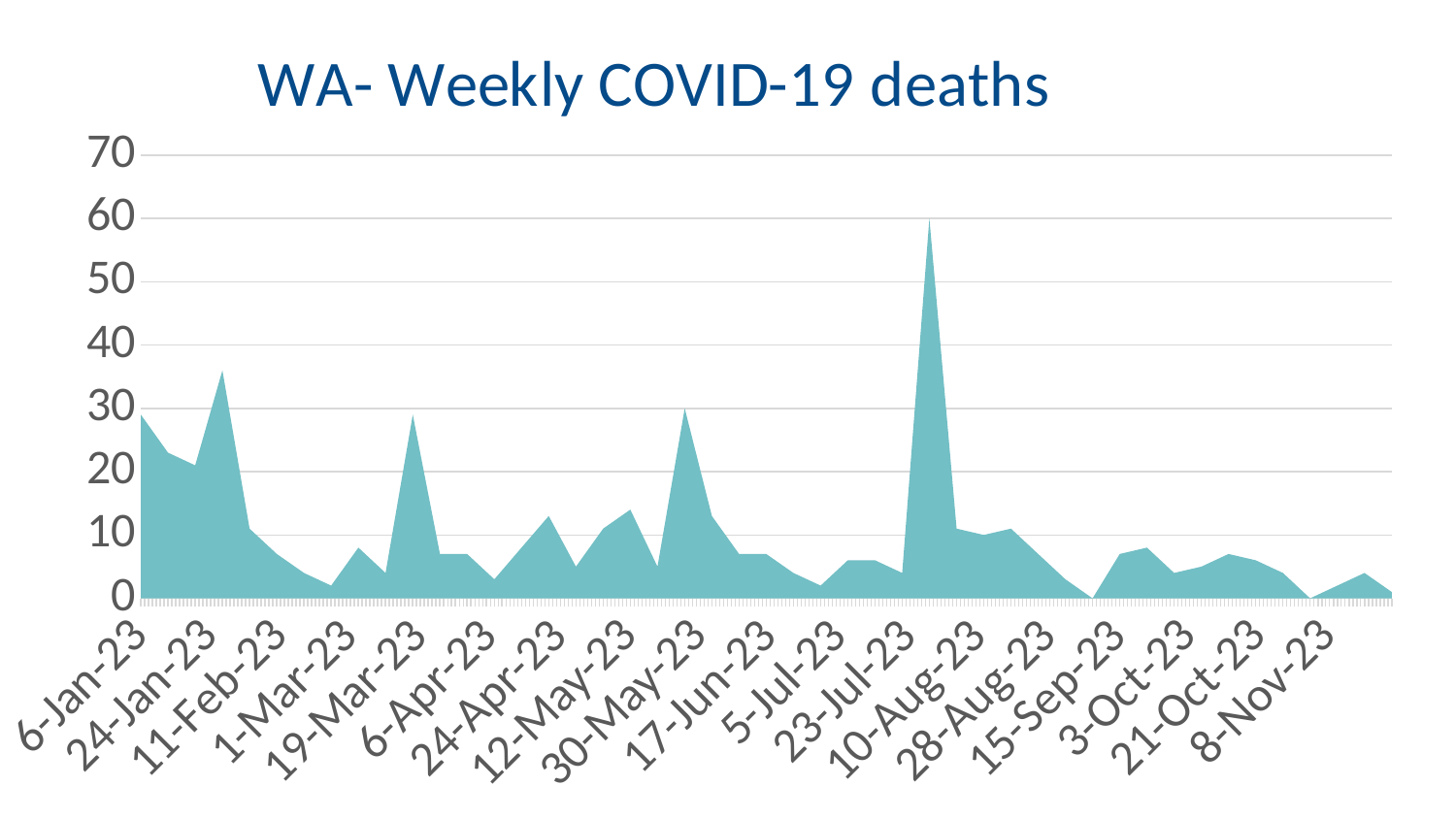
How many date labels are shown on the x axis? 18 Is the value for 5-Jul-23 greater or less than 10? less Is the value for 6-Jan-23 greater or less than 20? greater Which has the larger value, 6-Jan-23 or 8-Nov-23? 6-Jan-23 What kind of chart is shown on the slide? area chart Is the value for 8-Nov-23 greater or less than 10? less What is the highest value shown on the y axis? 70 Overall, do the weekly deaths rise or fall from the start of the chart to the end? fall What is the title of the chart? WA- Weekly COVID-19 deaths